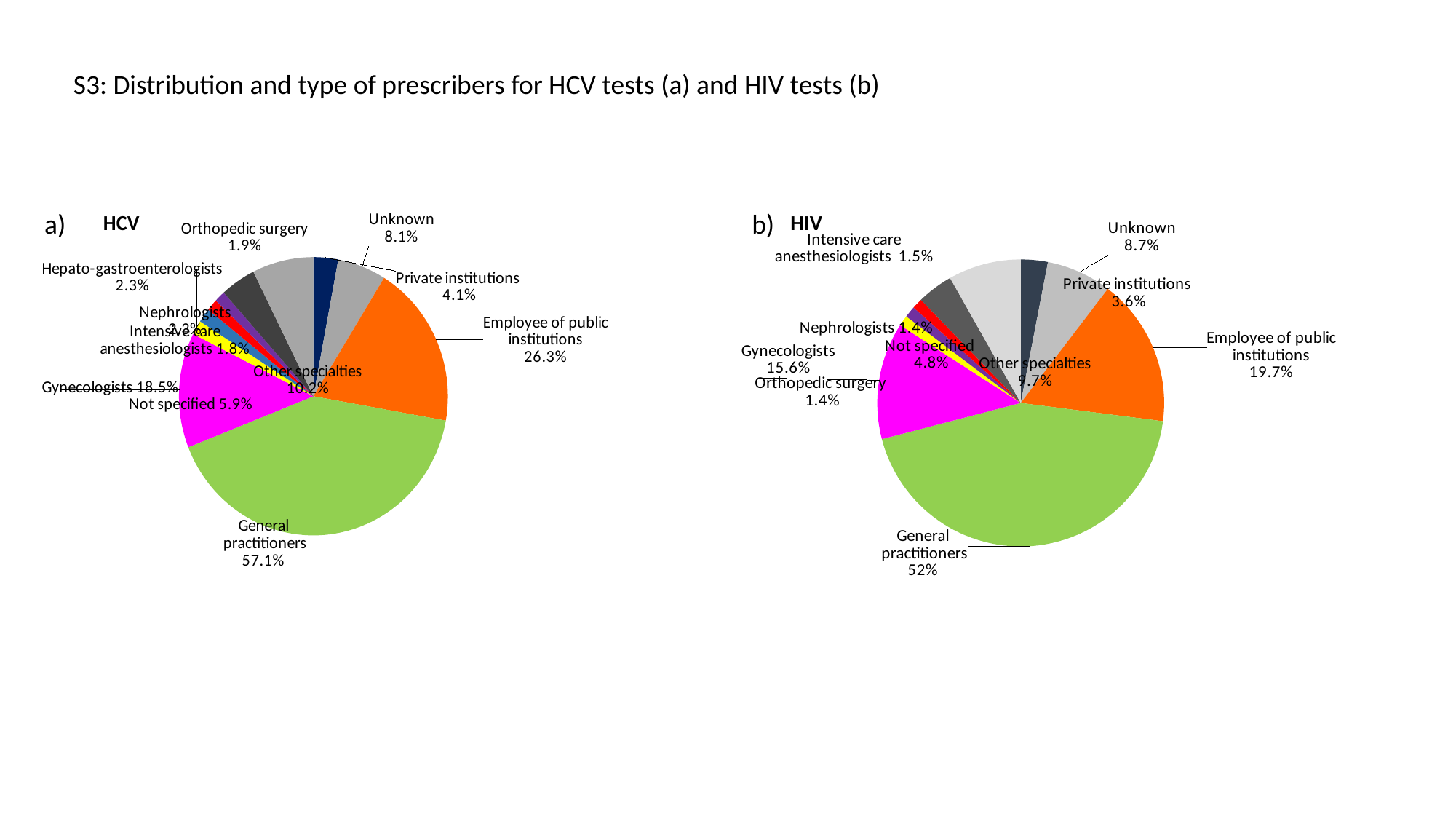
In the HIV chart (b), what percentage is shown for Unknown? 8.7% What type of chart is used for the HIV data (b)? Pie chart In the HIV chart (b), what share of prescribers are General practitioners? 52% In the HCV chart (a), what share of prescribers are General practitioners? 57.1% In the HIV chart (b), what percentage is shown for Gynecologists? 15.6% In the HCV chart (a), which category has the largest slice? General practitioners In the HIV chart (b), which category has the largest slice? General practitioners Is the Unknown share larger in the HCV chart (a) or the HIV chart (b)? HIV chart (b) In the HCV chart (a), what percentage is shown for Employee of public institutions? 26.3% In the HCV chart (a), what percentage is shown for Orthopedic surgery? 1.9% What is the difference between the General practitioners share in the HCV chart (a) and in the HIV chart (b)? 5.1% In the HIV chart (b), what percentage is shown for Employee of public institutions? 19.7%